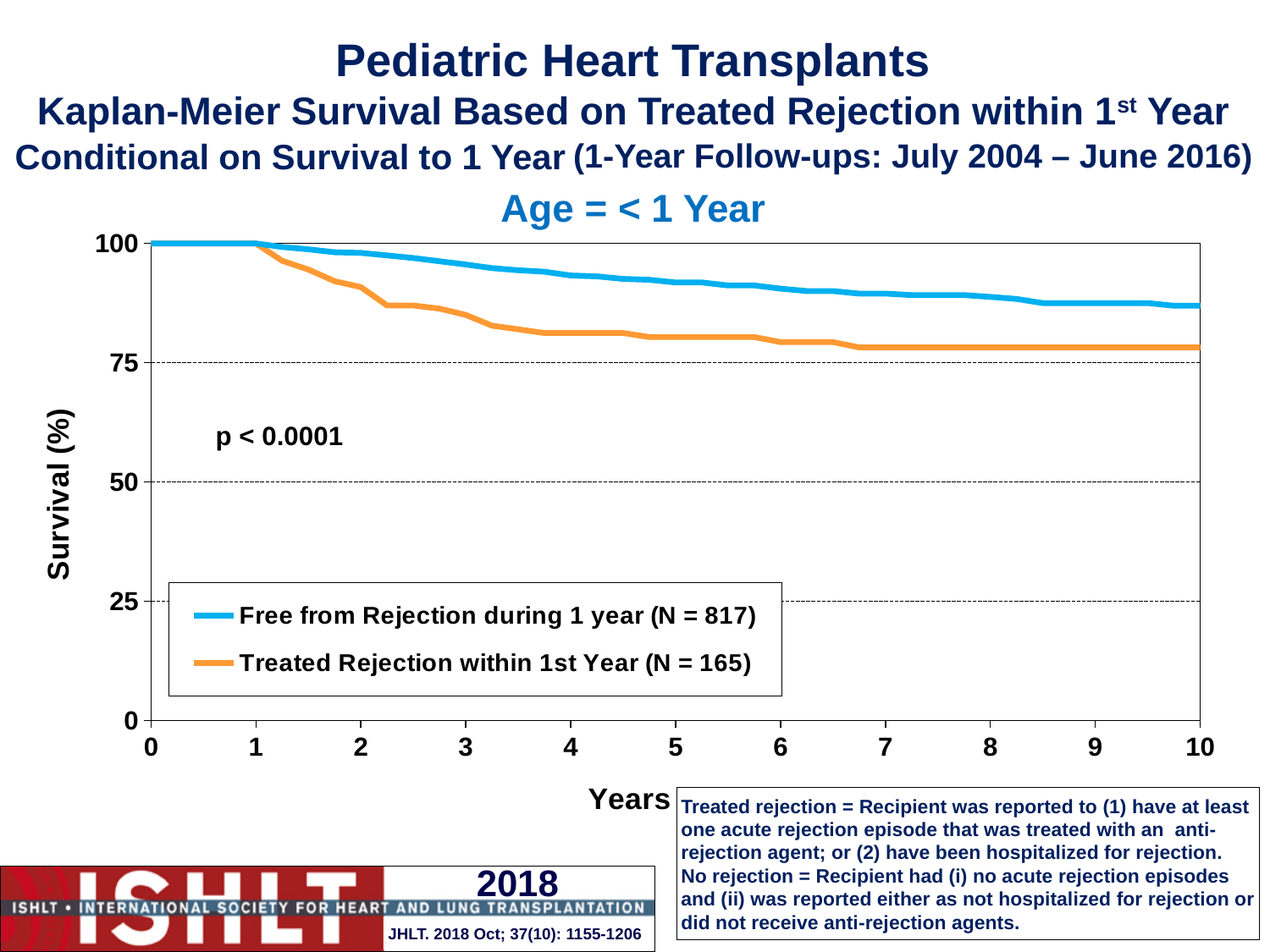
Do the survival curves rise or fall as years increase? Fall What is the N for the 'Treated Rejection within 1st Year' group shown in the legend? 165 Is the survival for 'Treated Rejection within 1st Year' at 3 years greater or less than 75? greater What kind of chart is shown on the slide? Line chart What is the N for the 'Free from Rejection during 1 year' group shown in the legend? 817 Which series has the higher survival at 5 years, 'Free from Rejection during 1 year' or 'Treated Rejection within 1st Year'? Free from Rejection during 1 year What is the label of the y axis? Survival (%) Is the survival for 'Treated Rejection within 1st Year' at 10 years greater or less than 50? greater Is the survival for 'Free from Rejection during 1 year' at 10 years greater or less than 75? greater What age group does the chart subtitle say the data covers? Age = < 1 Year How many series does the legend list? 2 What p-value is printed on the chart? p < 0.0001